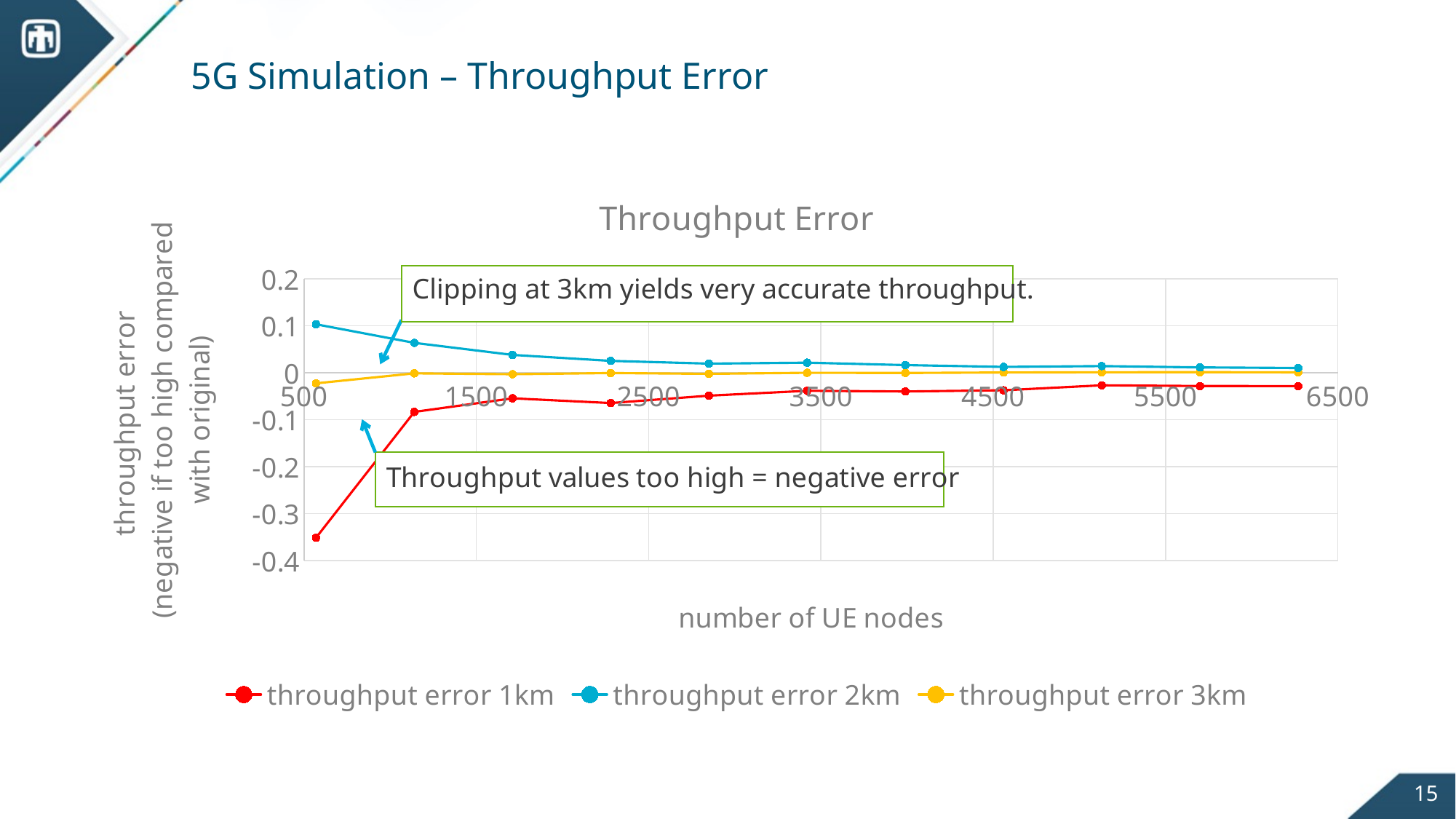
How many data points does the throughput error 1km series have? 11 Is the value for throughput error 1km at the last point (around 6300 UE nodes) greater or less than -0.1? greater Is the value for throughput error 2km at 500 UE nodes greater or less than 0? greater What is the label of the x axis? number of UE nodes What kind of chart is shown on the slide? line chart Is the value for throughput error 1km at 500 UE nodes greater or less than -0.3? less At 500 UE nodes, which series has the higher value, throughput error 1km or throughput error 2km? throughput error 2km What is the title of the chart? Throughput Error Which series has the lowest value at 500 UE nodes? throughput error 1km Does the throughput error 1km series rise or fall as the number of UE nodes increases? rise How many series does the legend list? 3 Does the throughput error 2km series rise or fall as the number of UE nodes increases? fall